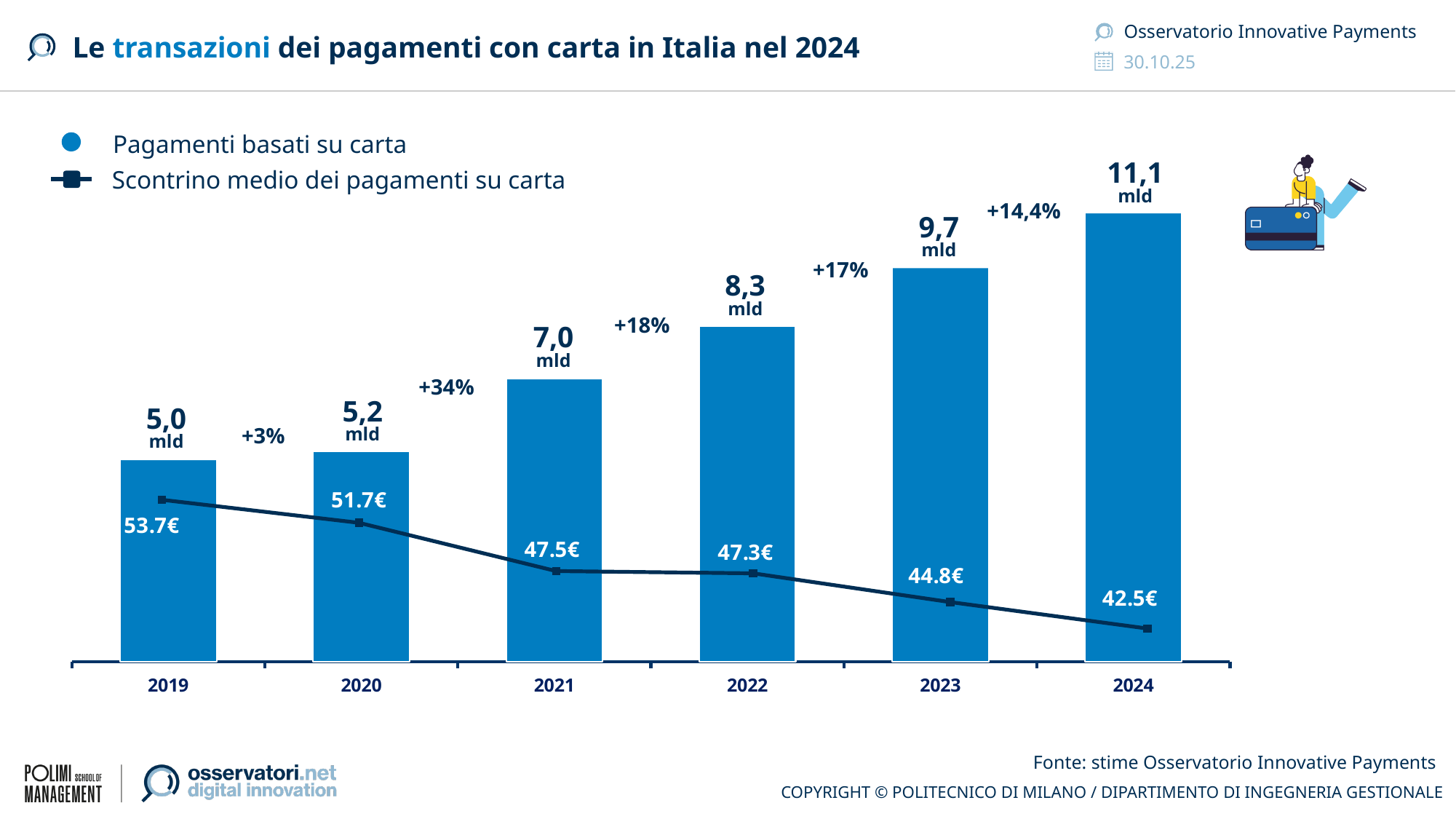
What is the difference in card-based payments between 2023 and 2022? 1,4 mld What percentage growth is shown between 2020 and 2021 for card-based payments? +34% What kind of chart is used for the 'Pagamenti basati su carta' series? Bar chart Which is larger: the average receipt in 2020 or in 2021? 2020 Does the average receipt (Scontrino medio) rise or fall from 2019 to 2024? Fall What is the average receipt (Scontrino medio) for card payments in 2019? 53.7€ Which year has the highest value of card-based payments? 2024 Which year has the lowest average receipt (Scontrino medio)? 2024 How many years are shown on the x axis? 6 What is the average receipt (Scontrino medio) for card payments in 2022? 47.3€ What is the value of card-based payments (Pagamenti basati su carta) in 2024? 11,1 mld How many series does the legend list? 2